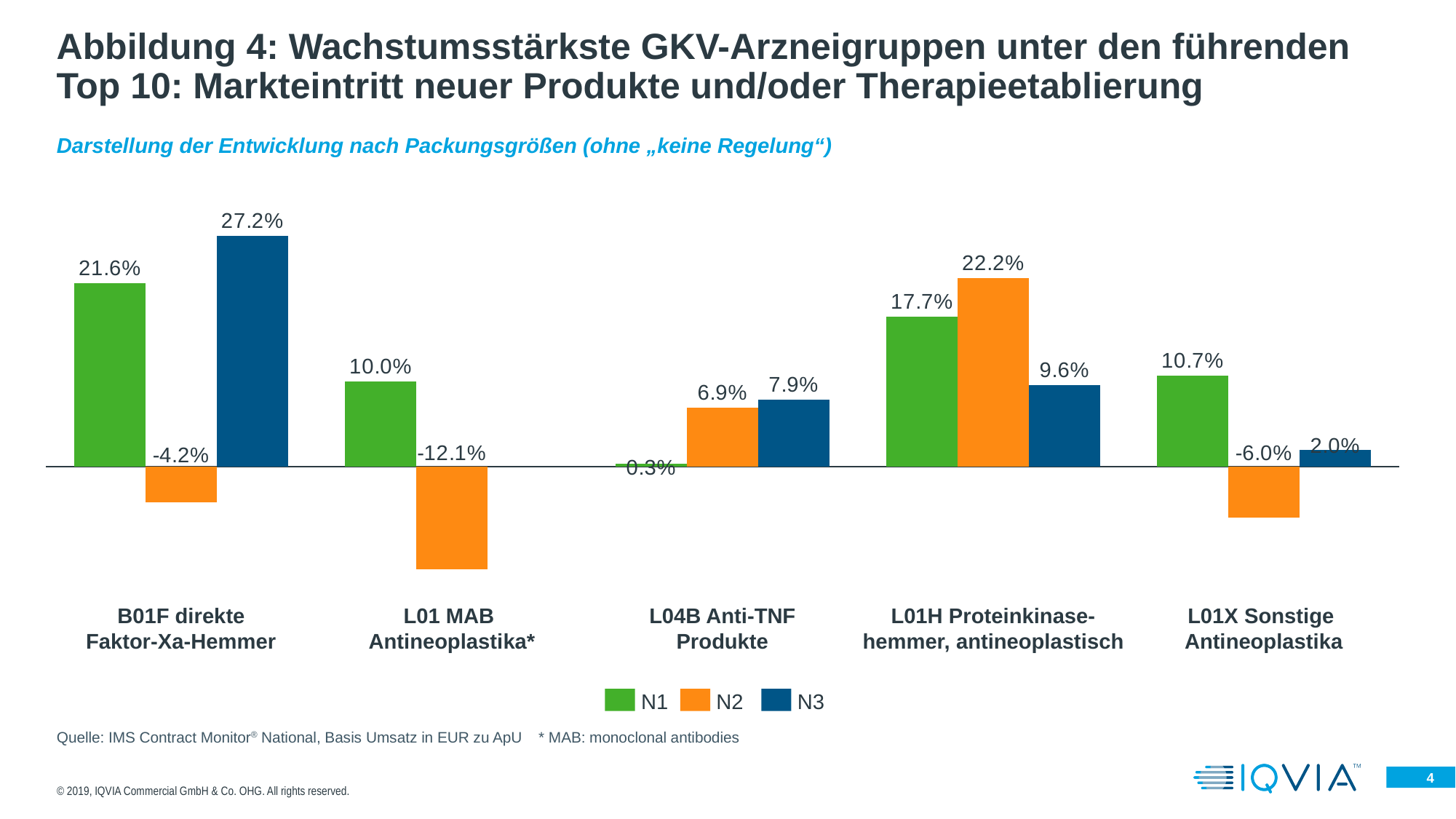
How many drug group categories are shown on the x axis? 5 Which category has the lowest N2 value? L01 MAB Antineoplastika* How many series does the legend list? 3 What is the difference between the N3 and N1 values for B01F direkte Faktor-Xa-Hemmer? 5.6 percentage points What is the N3 value for B01F direkte Faktor-Xa-Hemmer? 27.2% For L01H Proteinkinase-hemmer, antineoplastisch, which is larger: the N1 value or the N2 value? N2 Which category has the highest N1 value? B01F direkte Faktor-Xa-Hemmer What is the N2 value for L01 MAB Antineoplastika*? -12.1% What is the N3 value for L01X Sonstige Antineoplastika? 2.0% What is the N1 value for L04B Anti-TNF Produkte? 0.3% What kind of chart is shown on the slide? Bar chart What is the N2 value for L01H Proteinkinase-hemmer, antineoplastisch? 22.2%